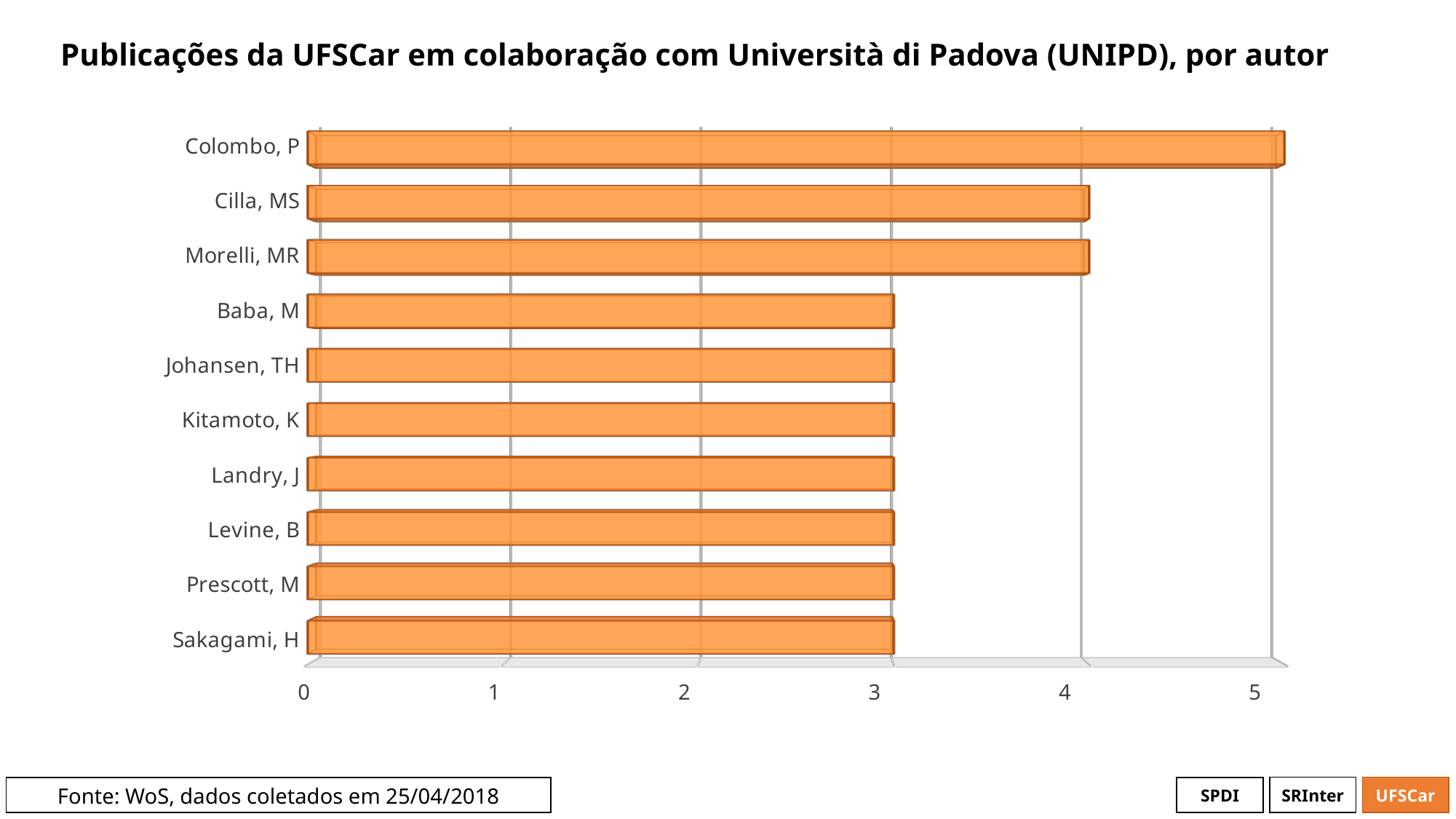
How many authors are listed in the chart? 10 How many authors have exactly 3 publications? 7 How many publications does Colombo, P have? 5 What kind of chart is shown on the slide? bar chart What is the difference in publications between Colombo, P and Morelli, MR? 1 How many publications does Baba, M have? 3 What is the title of the chart? Publicações da UFSCar em colaboração com Università di Padova (UNIPD), por autor Who has more publications, Cilla, MS or Sakagami, H? Cilla, MS What is the source of the data shown on the slide? WoS, dados coletados em 25/04/2018 Is the value for Colombo, P greater or less than 4? greater How many publications does Cilla, MS have? 4 Which author has the highest number of publications? Colombo, P